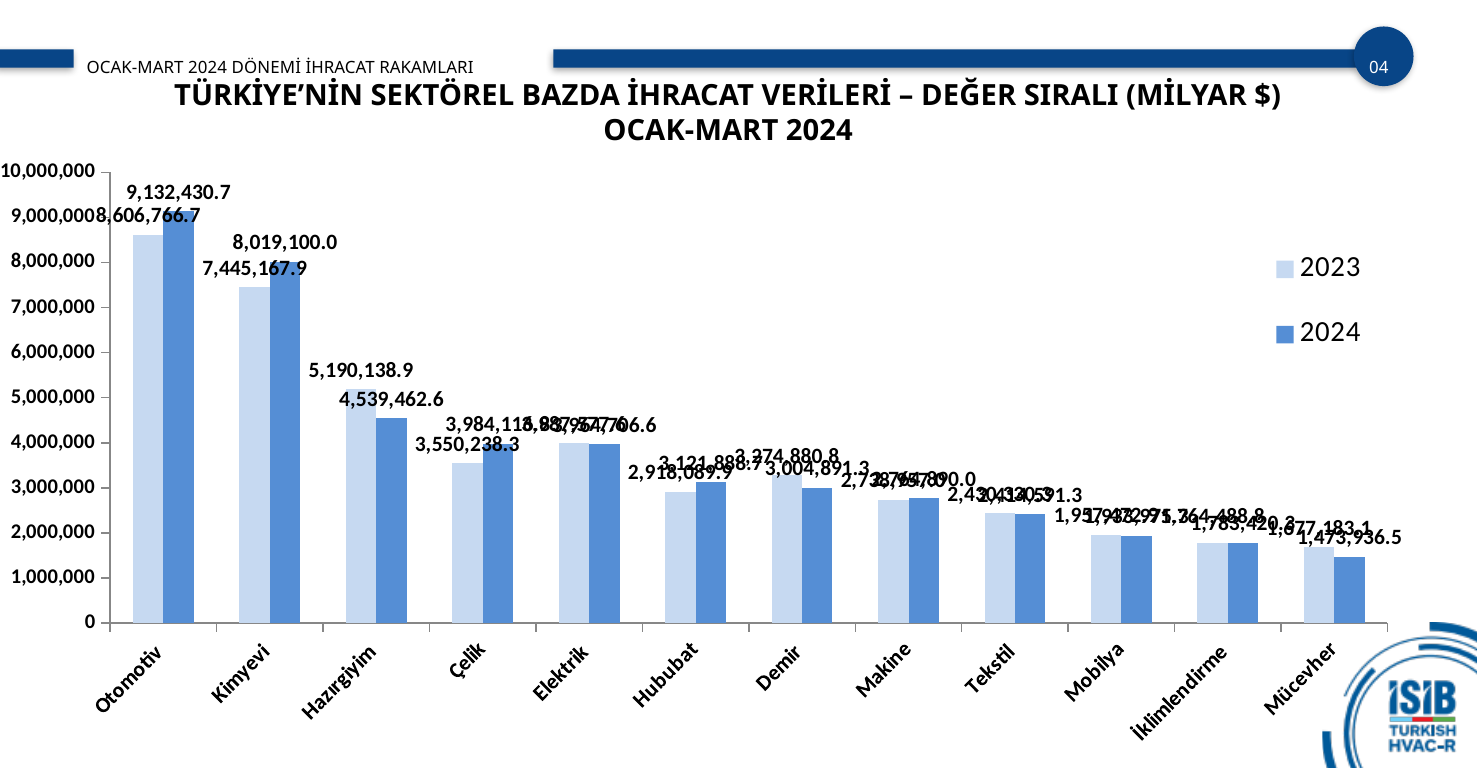
How many sectors are shown on the x axis? 12 What is the 2024 export value for Mücevher? 1,473,936.5 Which sector has the lowest 2024 export value? Mücevher For Hazırgiyim, which year has the larger export value, 2023 or 2024? 2023 What kind of chart is shown on the slide? bar chart How many series does the legend list? 2 What is the 2023 export value for Kimyevi? 7,445,167.9 What is the 2024 export value for Otomotiv? 9,132,430.7 Which sector has the highest 2024 export value? Otomotiv What is the difference between the 2024 and 2023 values for Kimyevi? 573,932.1 Is the 2024 value for Tekstil greater or less than 3,000,000? less What is the difference between the 2024 and 2023 values for Otomotiv? 525,664.0